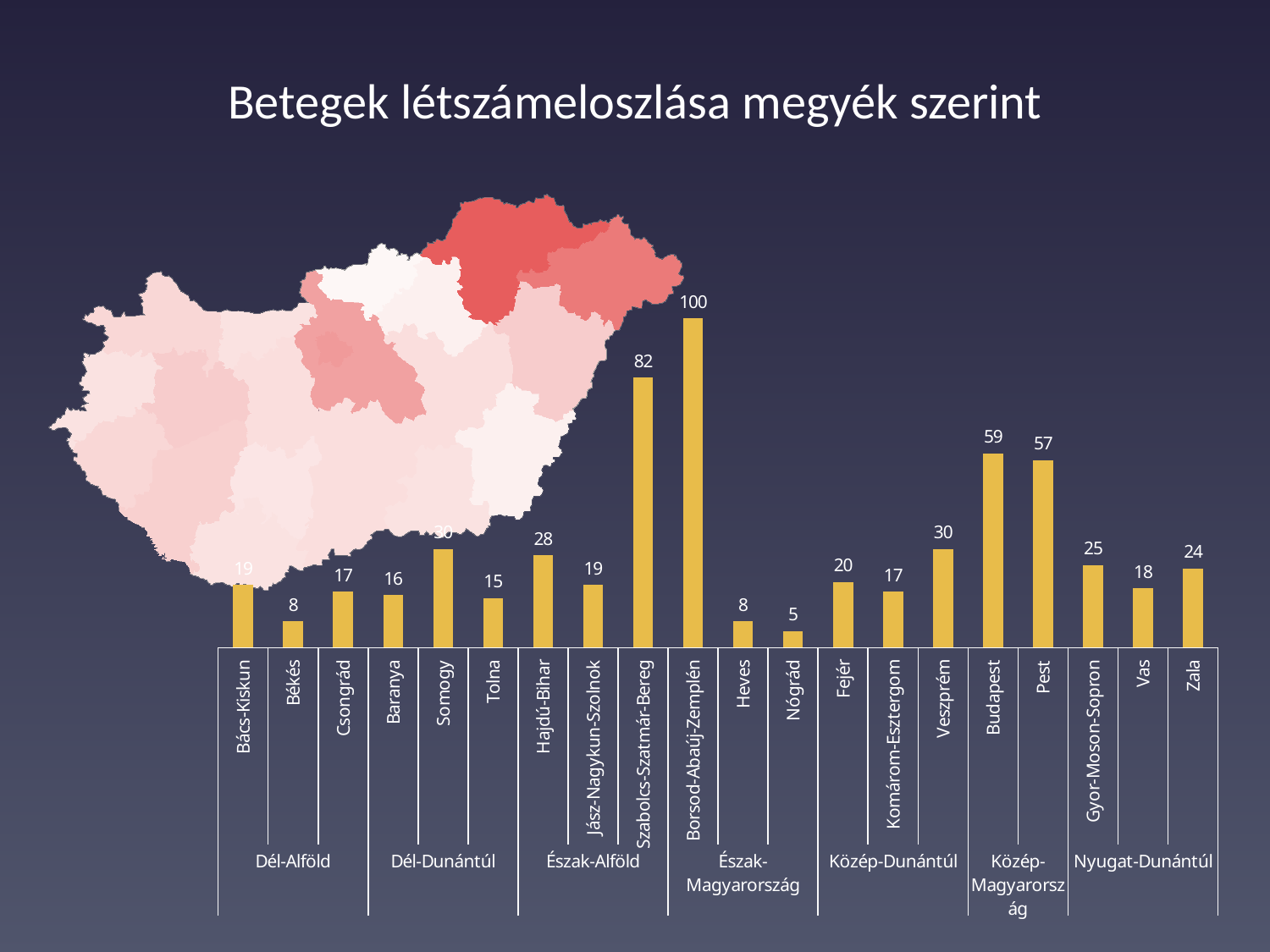
Which has a larger value, Hajdú-Bihar or Veszprém? Veszprém What is the difference between the values for Budapest and Pest? 2 Which county has the highest value? Borsod-Abaúj-Zemplén What is the value for Borsod-Abaúj-Zemplén? 100 What is the title of the chart? Betegek létszámeloszlása megyék szerint What is the value for Szabolcs-Szatmár-Bereg? 82 What is the value for Budapest? 59 How many counties are shown on the x axis? 20 Which county has the lowest value? Nógrád What is the difference between the values for Borsod-Abaúj-Zemplén and Szabolcs-Szatmár-Bereg? 18 What kind of chart is shown on the slide? Bar chart What is the value for Nógrád? 5